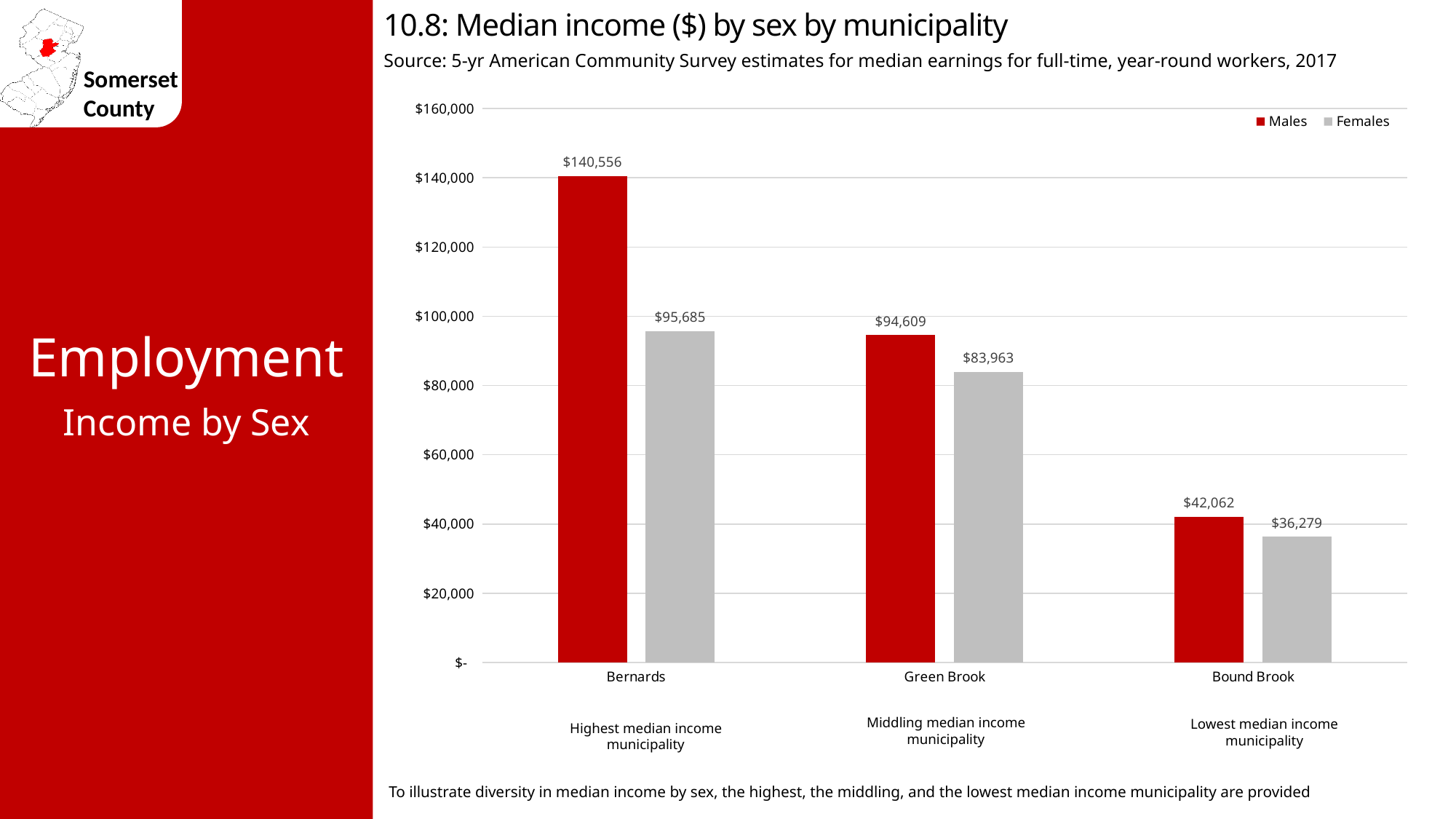
What is the median income for males in Bernards? $140,556 What kind of chart is shown on the slide? Bar chart What is the median income for females in Green Brook? $83,963 How many series does the legend list? 2 Which municipality has the highest median income for males? Bernards Which is larger: the median income for males in Green Brook or for females in Bernards? Females in Bernards What is the median income for females in Bound Brook? $36,279 What is the difference between male and female median income in Bound Brook? $5,783 What is the difference between male and female median income in Bernards? $44,871 How many municipalities are shown on the chart? 3 Which municipality has the lowest median income for females? Bound Brook Is the median income for males in Green Brook greater or less than $100,000? less